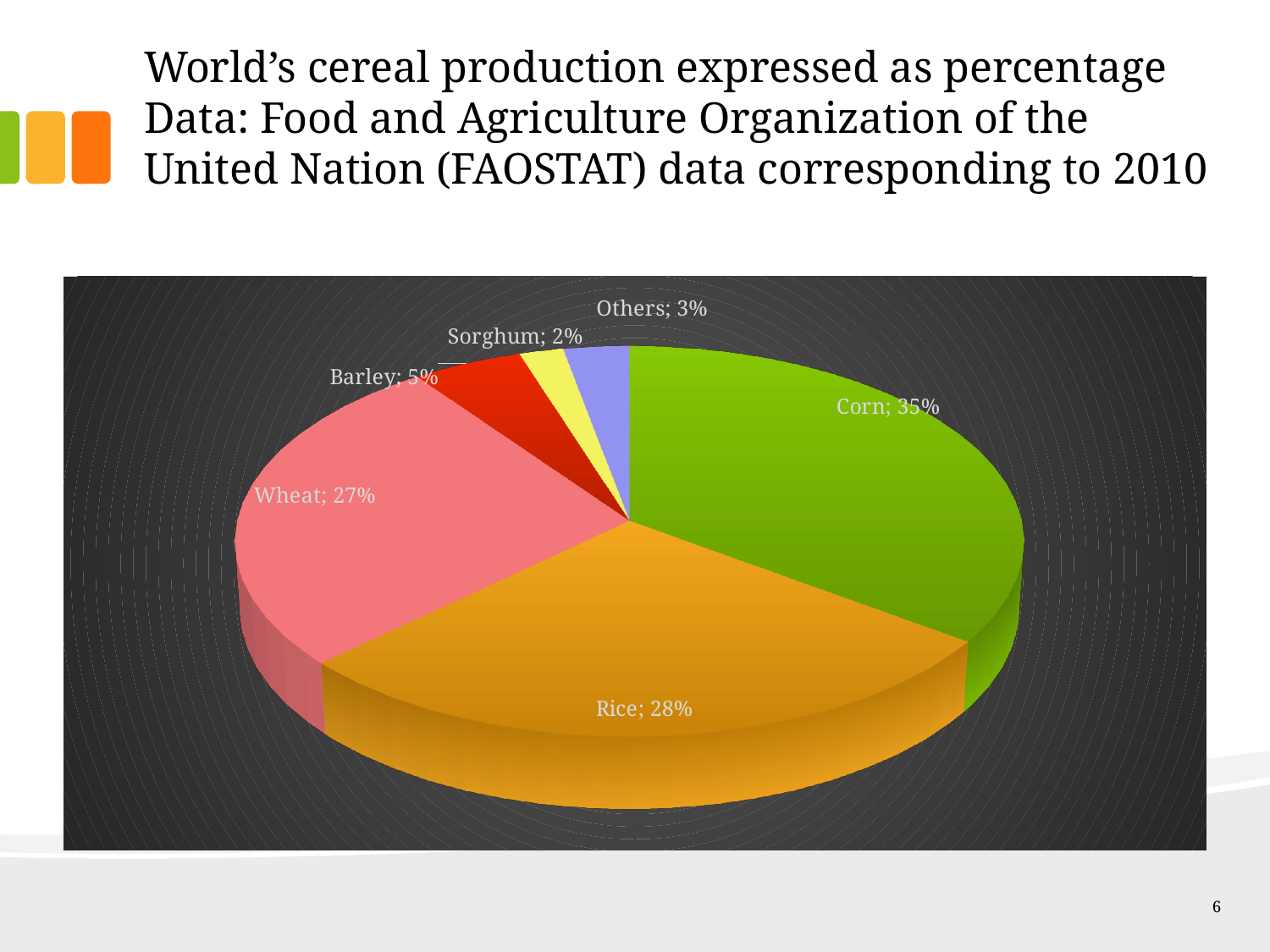
What is the difference in percentage points between Corn and Wheat? 8 What percentage is shown for Barley? 5% What percentage of world cereal production does Rice account for? 28% What colour is the Rice slice in the pie chart? Orange Which category has the smallest share in the pie chart? Sorghum What percentage of world cereal production does Corn account for? 35% Which cereal has the largest share of world production in the pie chart? Corn How many categories are shown in the pie chart? 6 What type of chart is shown on the slide? Pie chart What percentage of world cereal production does Wheat account for? 27% Which has a larger share, Barley or Others? Barley What percentage is shown for Sorghum? 2%